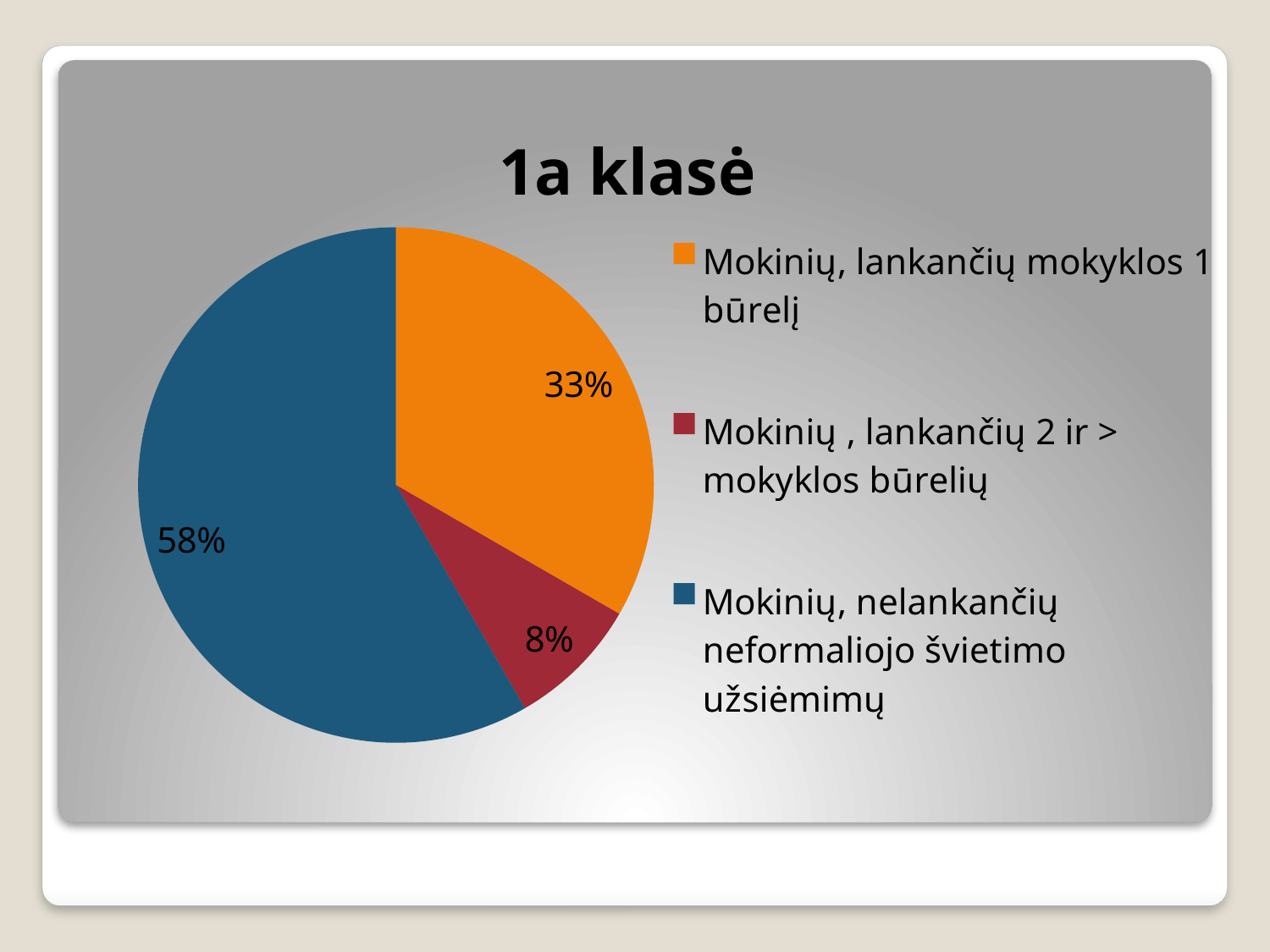
Which is larger: the slice for "Mokinių, lankančių mokyklos 1 būrelį" or the slice for "Mokinių , lankančių 2 ir > mokyklos būrelių"? Mokinių, lankančių mokyklos 1 būrelį What share of the pie is labelled "Mokinių, lankančių mokyklos 1 būrelį"? 33% How many entries does the legend list? 3 Which category has the largest slice of the pie? Mokinių, nelankančių neformaliojo švietimo užsiėmimų How many slices does the pie chart have? 3 What colour is the slice for "Mokinių, nelankančių neformaliojo švietimo užsiėmimų"? blue What share of the pie is labelled "Mokinių , lankančių 2 ir > mokyklos būrelių"? 8% What share of the pie is labelled "Mokinių, nelankančių neformaliojo švietimo užsiėmimų"? 58% What is the title of the chart? 1a klasė What is the difference in percentage points between the "Mokinių, nelankančių neformaliojo švietimo užsiėmimų" slice and the "Mokinių, lankančių mokyklos 1 būrelį" slice? 25% Which category has the smallest slice of the pie? Mokinių , lankančių 2 ir > mokyklos būrelių What kind of chart is shown on the slide? pie chart